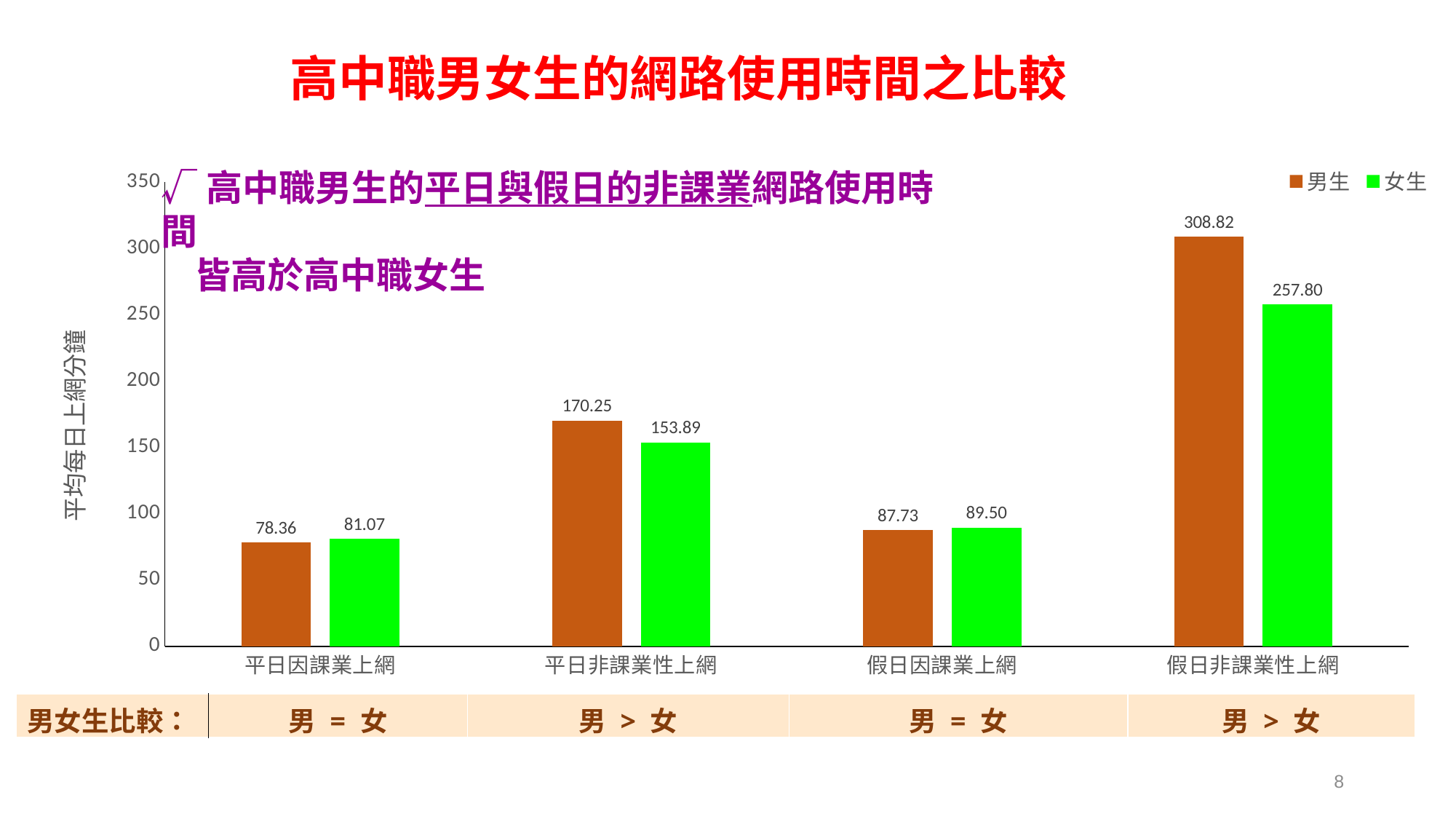
Which category has the highest value for 男生? 假日非課業性上網 What is the value for 男生 in the 平日因課業上網 category? 78.36 How many series does the legend list? 2 What is the value for 女生 in the 平日非課業性上網 category? 153.89 What is the value for 男生 in the 假日因課業上網 category? 87.73 What kind of chart is shown on the slide? bar chart How many categories are shown on the x axis? 4 Which category has the lowest value for 女生? 平日因課業上網 Which is larger in the 假日非課業性上網 category, 男生 or 女生? 男生 What is the value for 女生 in the 假日非課業性上網 category? 257.80 What is the difference between the 男生 and 女生 values in the 平日非課業性上網 category? 16.36 What is the difference between the 男生 and 女生 values in the 假日非課業性上網 category? 51.02